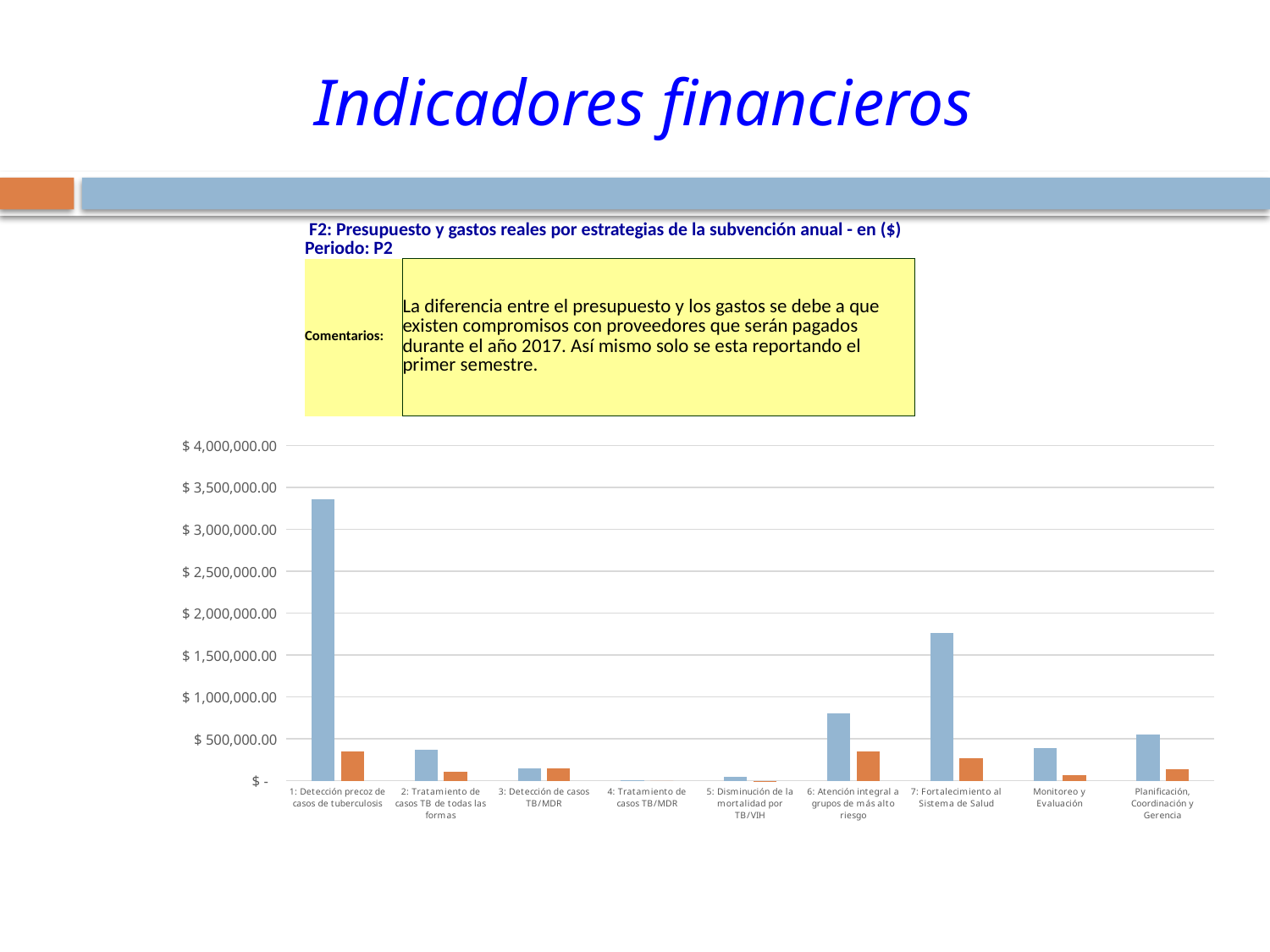
Which category has the shortest blue bar in the chart? 4: Tratamiento de casos TB/MDR Which category has the tallest blue bar in the chart? 1: Detección precoz de casos de tuberculosis Is the blue bar for '7: Fortalecimiento al Sistema de Salud' greater or less than $2,000,000.00? less Is the blue bar for '7: Fortalecimiento al Sistema de Salud' greater or less than $1,500,000.00? greater Is the orange bar for '1: Detección precoz de casos de tuberculosis' greater or less than $500,000.00? less For '1: Detección precoz de casos de tuberculosis', which bar is taller, the blue one or the orange one? the blue one How many categories are shown along the x axis of the chart? 9 What kind of chart is shown on the slide? bar chart Which has the taller blue bar: '6: Atención integral a grupos de más alto riesgo' or '7: Fortalecimiento al Sistema de Salud'? 7: Fortalecimiento al Sistema de Salud